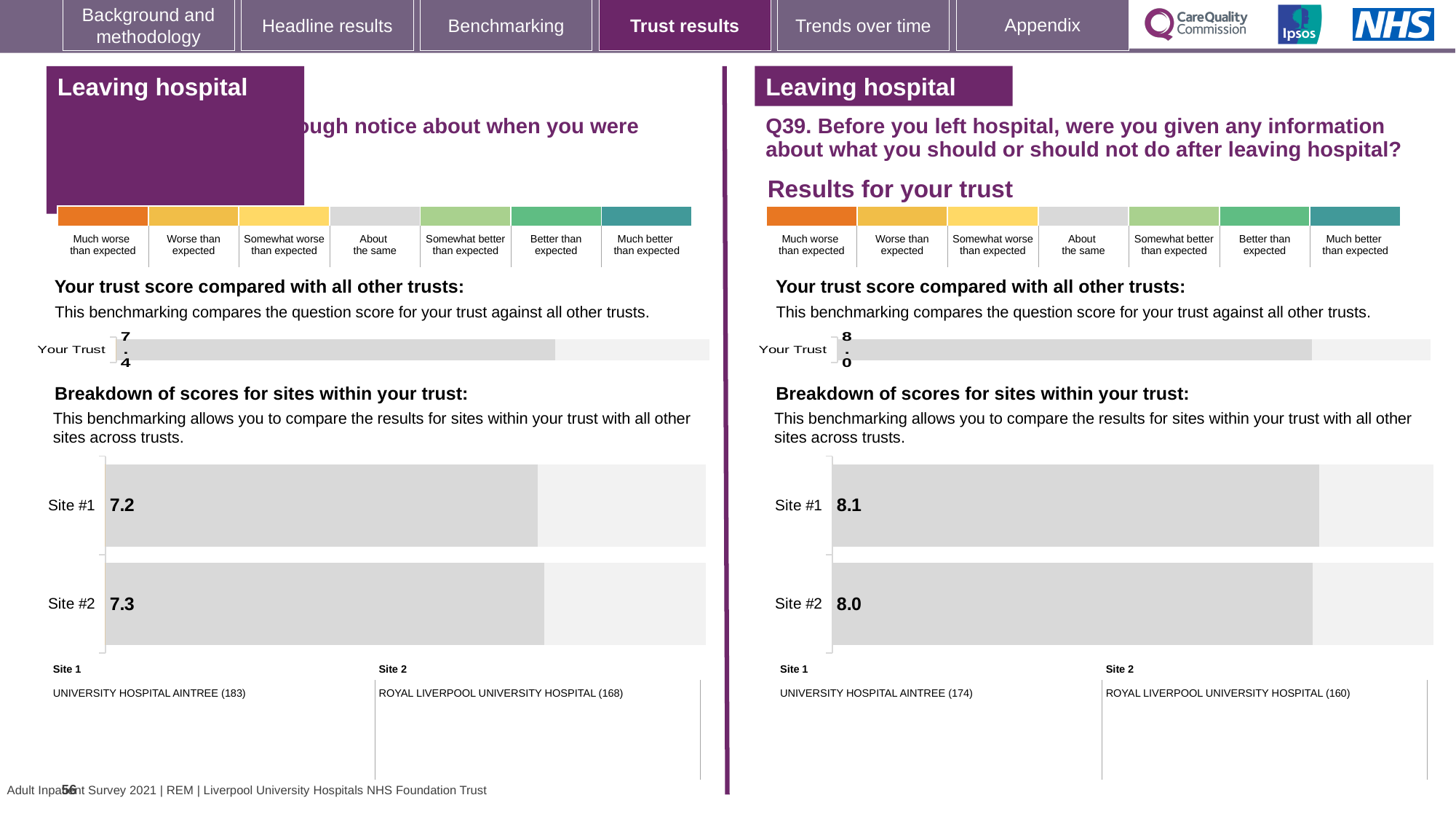
What type of chart is used to show the site breakdown scores on the right-hand side of the slide? Bar chart How many sites are shown in the left-hand site breakdown chart? 2 On the right-hand side of the slide (Q39), what is the score shown for Your Trust in the trust score bar chart? 8.0 In the Q39 site breakdown chart on the right, which site has the lower score? Site #2 In the Q39 site breakdown chart on the right, what is the difference between the Site #1 and Site #2 scores? 0.1 In the left-hand site breakdown chart, which site has the higher score? Site #2 In the left-hand site breakdown chart, what is the score for Site #1? 7.2 On the left-hand side of the slide, what is the score shown for Your Trust in the trust score bar chart? 7.4 In the Q39 site breakdown chart on the right, what is the score for Site #2? 8.0 In the left-hand site breakdown chart, what is the score for Site #2? 7.3 In the Q39 site breakdown chart on the right, what is the score for Site #1? 8.1 According to the site key on the right-hand side of the slide, which hospital is Site 1 for Q39? UNIVERSITY HOSPITAL AINTREE (174)